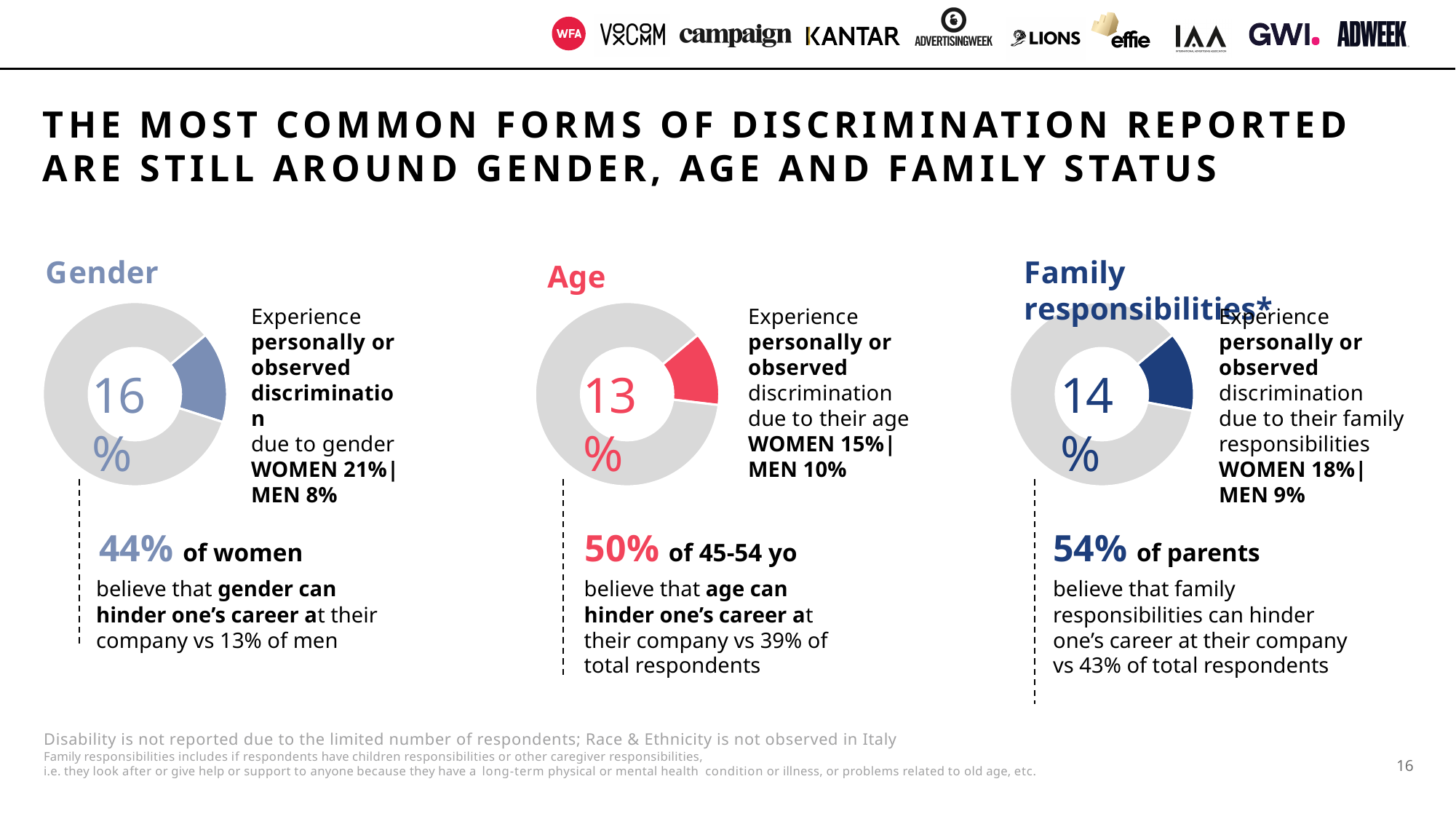
Of the three donut charts (Gender, Age, Family responsibilities), which shows the highest percentage? Gender Of the three donut charts (Gender, Age, Family responsibilities), which shows the lowest percentage? Age How many donut charts are shown on the slide? 3 What is the difference in percentage points between the Gender donut chart value and the Age donut chart value? 3 percentage points Which is larger: the value in the Family responsibilities donut chart or the value in the Age donut chart? Family responsibilities What colour is the highlighted slice in the Age donut chart? Red/pink What is the difference in percentage points between the Gender donut chart value and the Family responsibilities donut chart value? 2 percentage points In the Family responsibilities donut chart, what percentage is shown in the centre? 14% In the Gender donut chart, what percentage is shown in the centre? 16% In the Age donut chart, what percentage is shown in the centre? 13% What kind of chart is used to show the Gender, Age and Family responsibilities percentages? Donut (pie) chart In the Gender donut chart, what share of the ring does the coloured slice represent? 16%